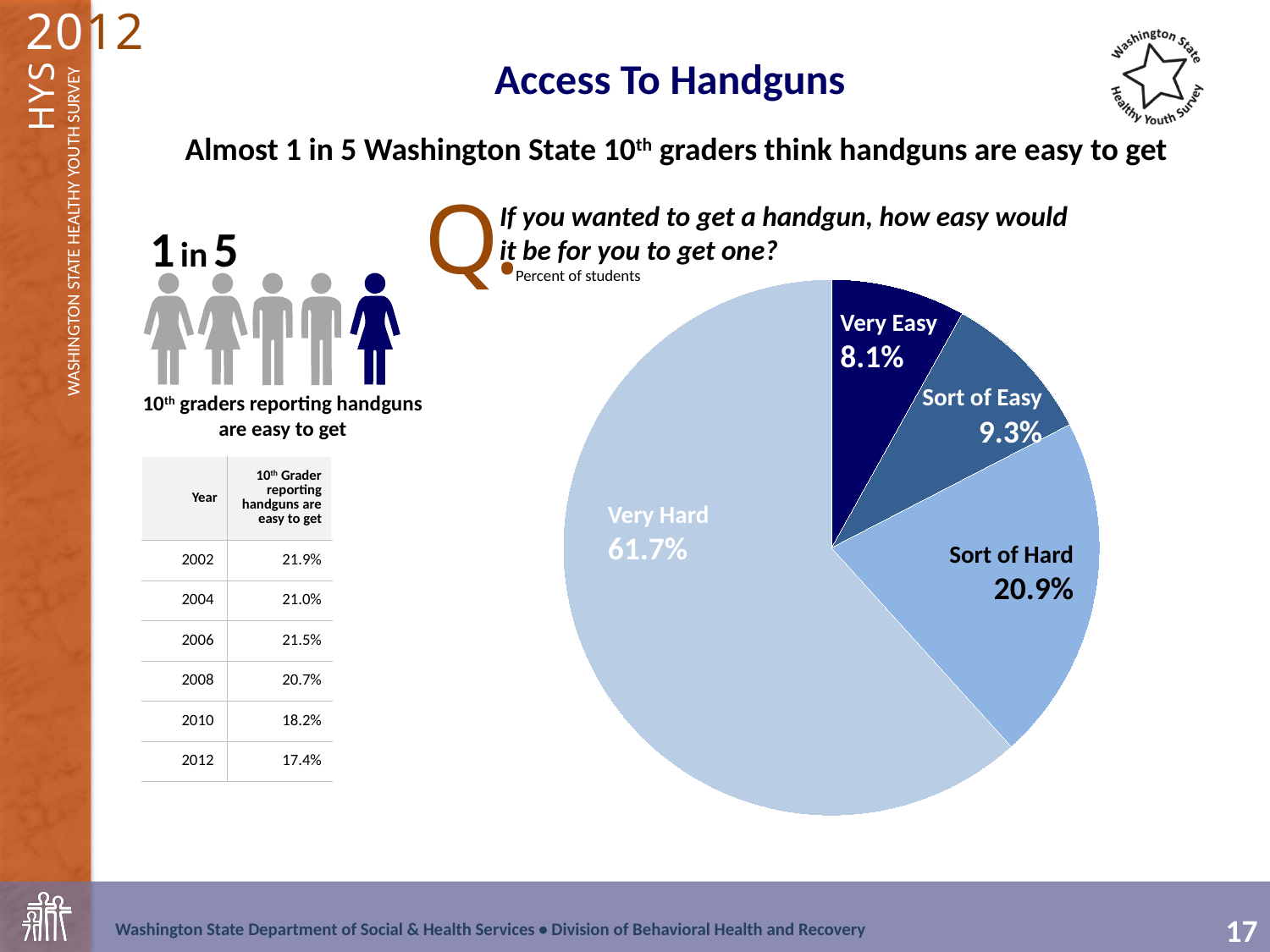
Which slice of the pie chart is the largest? Very Hard What kind of chart is shown on the slide? pie chart What is the difference in percentage points between the "Sort of Hard" and "Sort of Easy" slices? 11.6 What percentage of students answered "Sort of Hard" in the pie chart? 20.9% How many slices does the pie chart have? 4 What percentage of students answered "Very Easy" in the pie chart? 8.1% Which slice of the pie chart is the smallest? Very Easy Which is larger in the pie chart, "Sort of Easy" or "Very Easy"? Sort of Easy What percentage of students answered "Sort of Easy" in the pie chart? 9.3% What percentage of students answered "Very Hard" in the pie chart? 61.7% What is the combined percentage of the "Very Easy" and "Sort of Easy" slices? 17.4% What survey question does the pie chart report responses to? If you wanted to get a handgun, how easy would it be for you to get one?